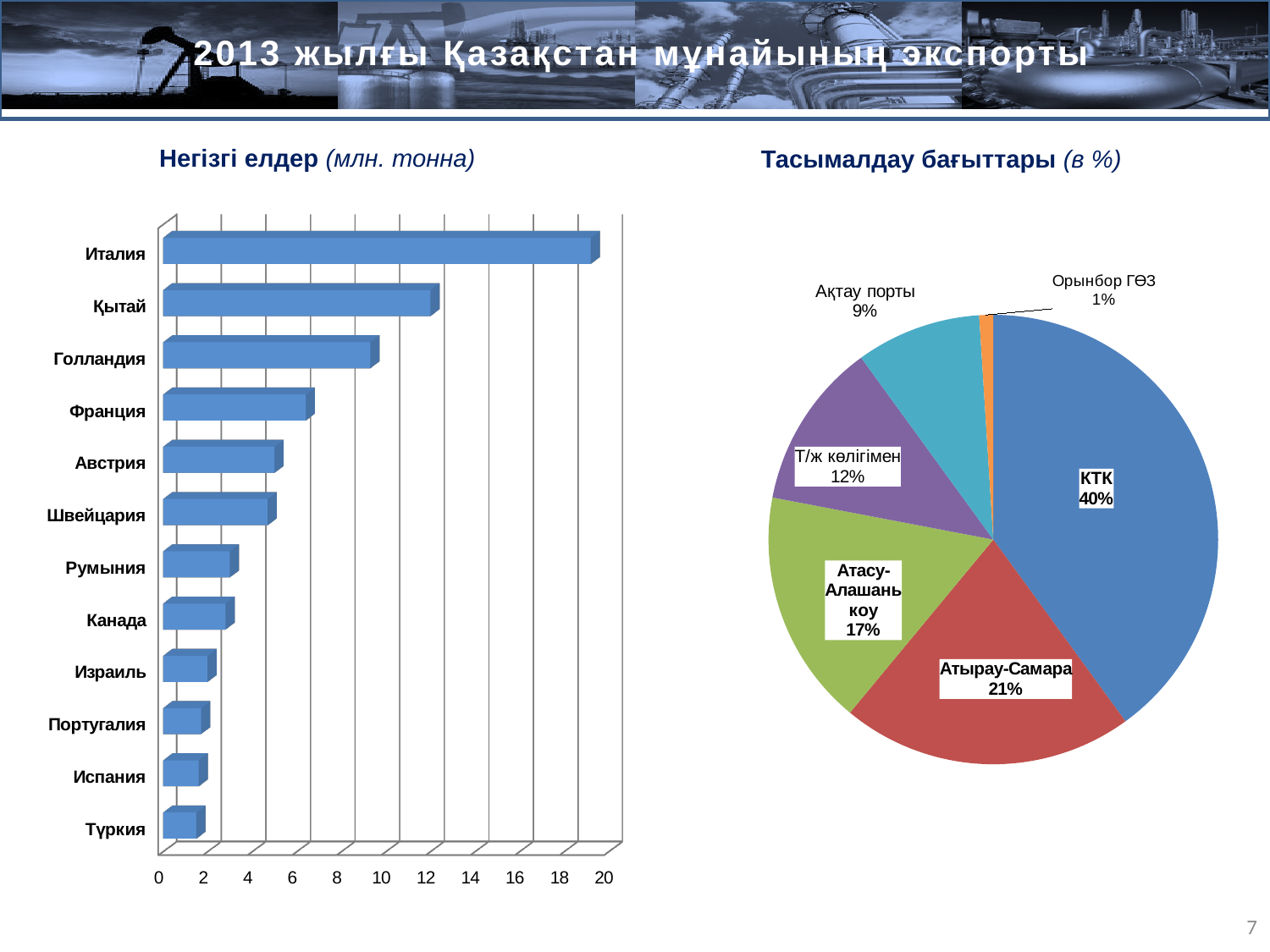
In the 'Негізгі елдер (млн. тонна)' bar chart, which country has the highest value? Италия In the 'Негізгі елдер (млн. тонна)' bar chart, is the value for Голландия greater or less than 10? less In the 'Негізгі елдер (млн. тонна)' bar chart, which is larger, the value for Голландия or the value for Франция? Голландия What kind of chart is the 'Тасымалдау бағыттары (в %)' chart on the right? pie chart In the 'Тасымалдау бағыттары (в %)' pie chart, which direction has the smallest share? Орынбор ГӨЗ In the 'Тасымалдау бағыттары (в %)' pie chart, what is the value for Атасу-Алашанькоу? 17% What kind of chart is the 'Негізгі елдер (млн. тонна)' chart on the left? bar chart How many countries are shown in the 'Негізгі елдер (млн. тонна)' bar chart? 12 In the 'Негізгі елдер (млн. тонна)' bar chart, is the value for Қытай greater or less than 10? greater In the 'Негізгі елдер (млн. тонна)' bar chart, is the value for Италия greater or less than 18? greater In the 'Тасымалдау бағыттары (в %)' pie chart, what is the difference between the shares of Атырау-Самара and Т/ж көлігімен? 9% In the 'Тасымалдау бағыттары (в %)' pie chart, what share does КТК have? 40%